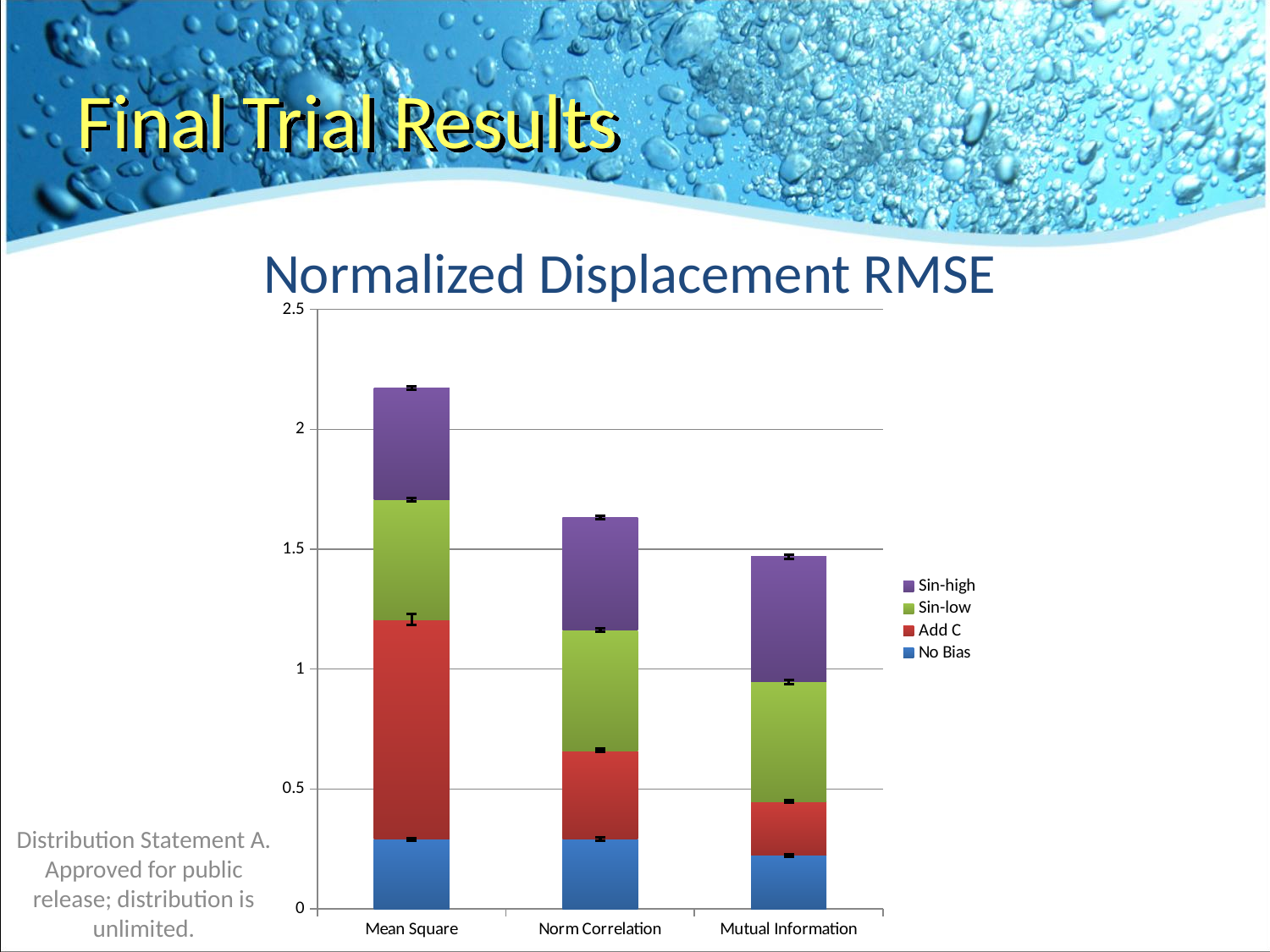
Which category has the shortest stacked bar? Mutual Information Is the total of the Mutual Information stacked bar greater or less than 1? greater What kind of chart is shown on the slide? Stacked bar chart What is the title of the chart? Normalized Displacement RMSE Do the stacked bar totals rise or fall from left to right along the x axis? Fall Which stacked bar is taller, Mean Square or Norm Correlation? Mean Square How many categories are shown on the x axis of the chart? 3 Which category has the tallest stacked bar? Mean Square How many series does the chart's legend list? 4 Which series is shown at the bottom of each stacked bar, according to the legend colours? No Bias Is the total of the Norm Correlation stacked bar greater or less than 1.5? greater Is the total of the Mean Square stacked bar greater or less than 2? greater